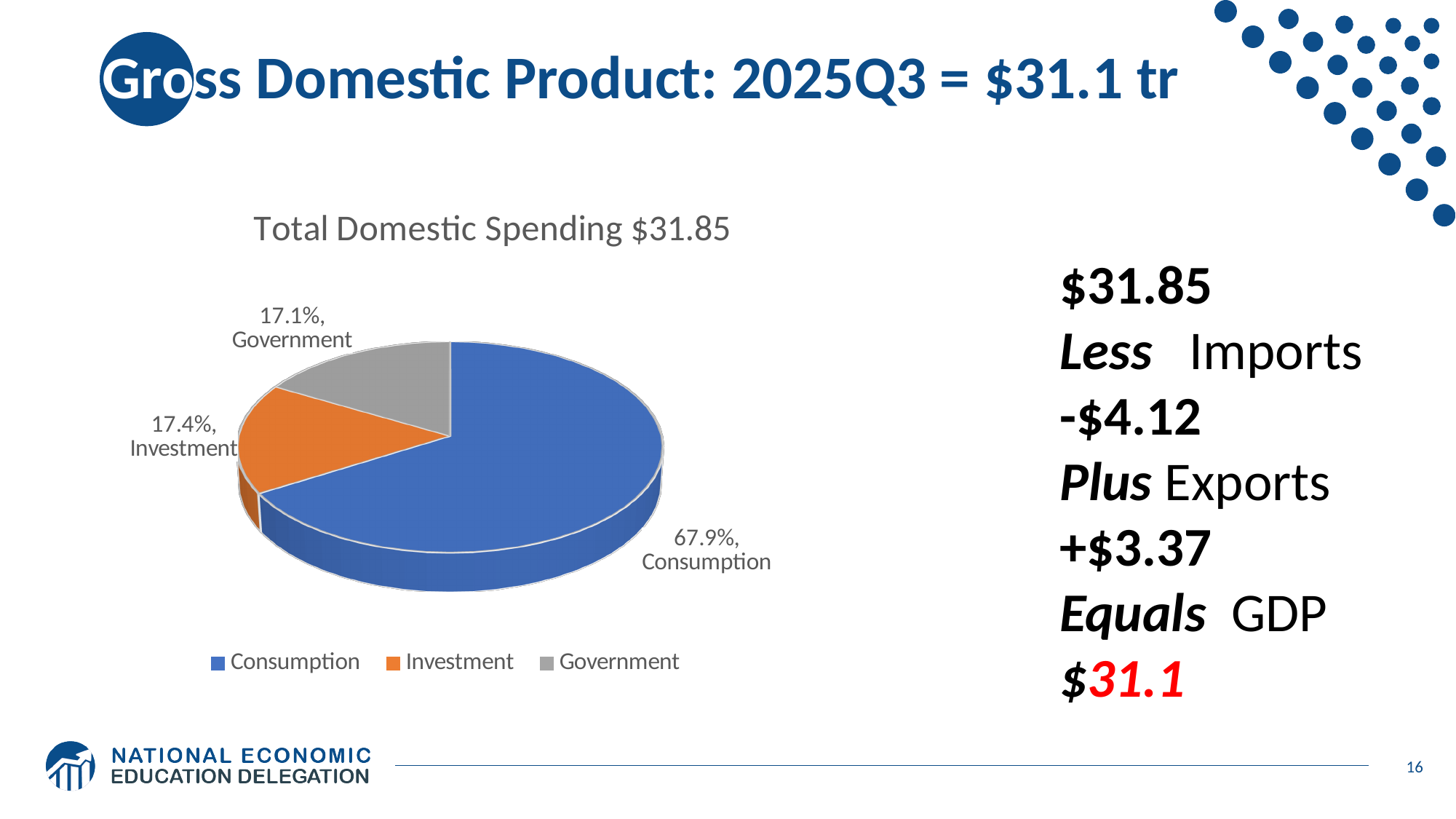
What is the title of the chart? Total Domestic Spending $31.85 How many slices does the pie chart have? 3 What is the difference in percentage points between the Investment and Government shares? 0.3 What share of the pie does Government account for? 17.1% How many entries does the legend list? 3 What share of the pie does Consumption account for? 67.9% What is the difference in percentage points between the Consumption and Investment shares? 50.5 Which category has the largest slice of the pie? Consumption What kind of chart is shown on the slide? Pie chart Which is larger, the Consumption share or the Government share? Consumption Which category has the smallest slice of the pie? Government What share of the pie does Investment account for? 17.4%